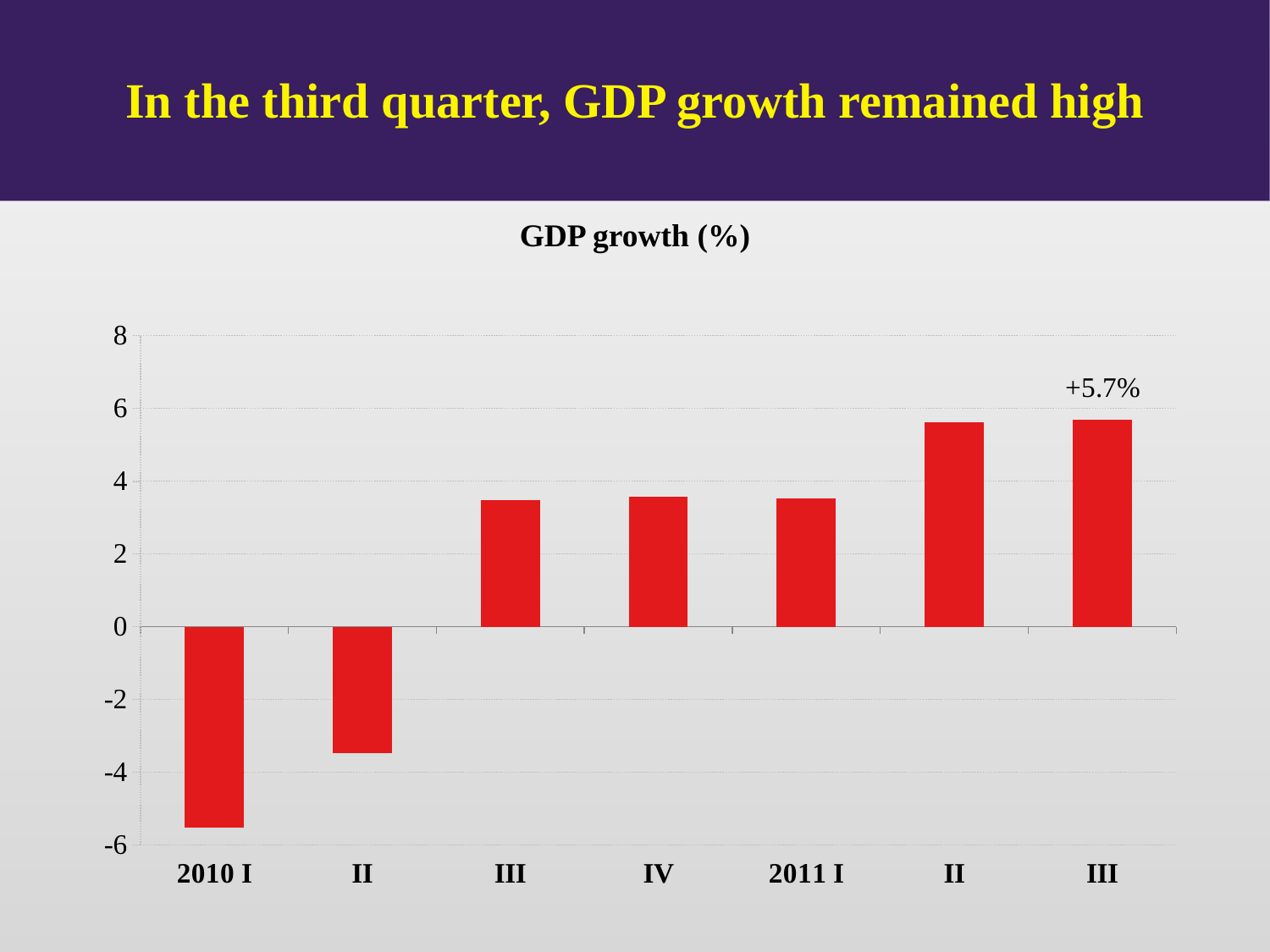
Do the GDP growth values generally rise or fall from 2010 I to 2011 III? rise Is the value for 2010 III greater or less than 4? less Which is larger, the GDP growth for 2010 I or for 2011 III? 2011 III What kind of chart is shown on the slide? bar chart How many quarters are plotted on the chart? 7 What is the GDP growth value shown for 2011 III? +5.7% What is the title of the chart? GDP growth (%) Which is larger, the GDP growth for 2010 III or for 2011 II? 2011 II Is the value for 2010 II greater or less than -2? less Is the value for 2011 II greater or less than 4? greater Which quarter has the lowest GDP growth? 2010 I